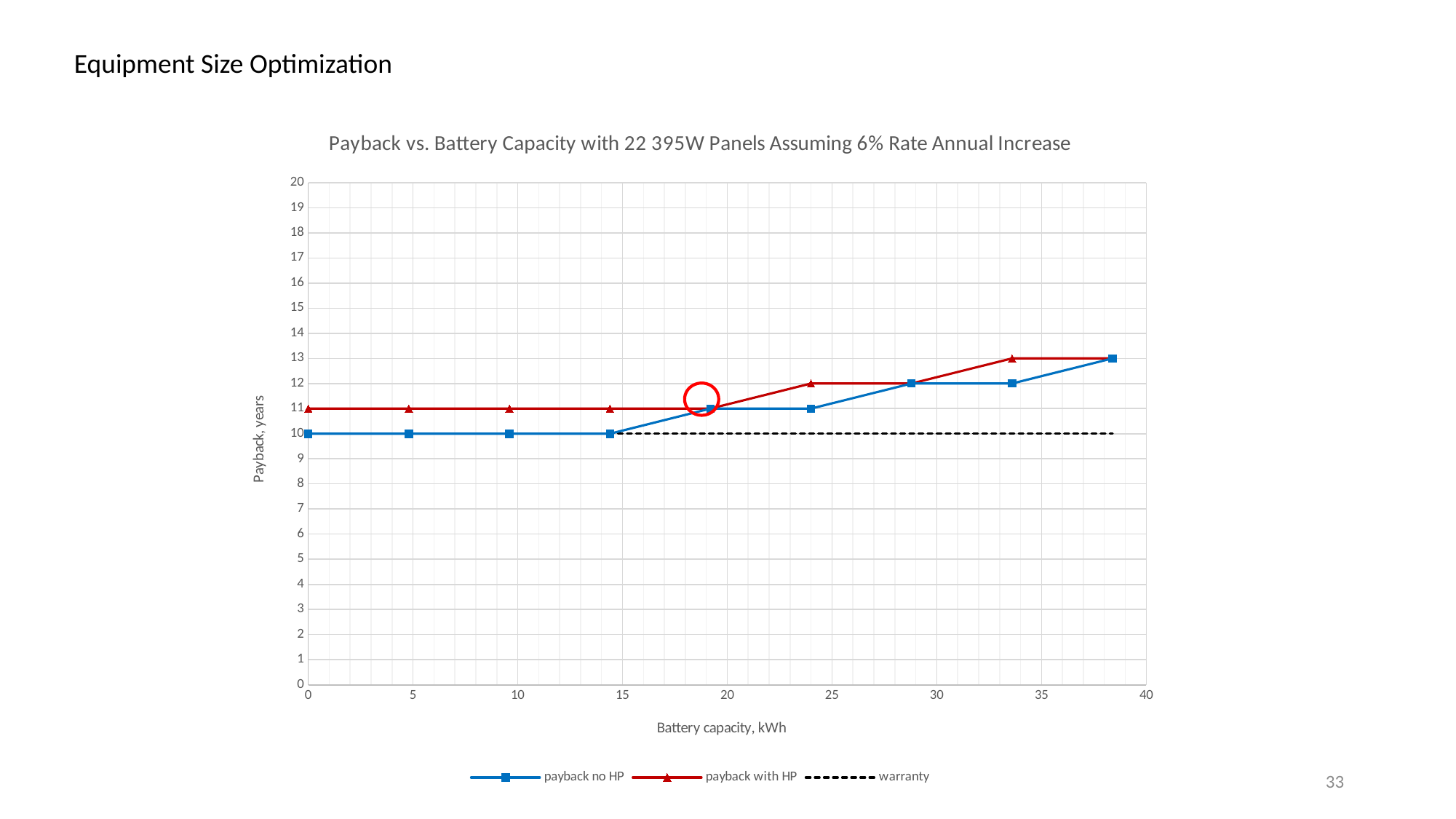
At a battery capacity of 0 kWh, which series has the larger payback: payback no HP or payback with HP? payback with HP What is the highest payback value reached by the payback no HP series? 13 What is the lowest payback value of the payback with HP series? 11 What is the payback no HP value at a battery capacity of 0 kWh? 10 At a battery capacity of 0 kWh, what is the difference between payback with HP and payback no HP? 1 What kind of chart is shown on the slide? line chart At what payback value does the warranty line sit? 10 Does the payback no HP series rise or fall as battery capacity increases? rise What is the label of the x axis? Battery capacity, kWh How many series does the legend list? 3 What is the payback with HP value at a battery capacity of 0 kWh? 11 How many data points are plotted for the payback no HP series? 9